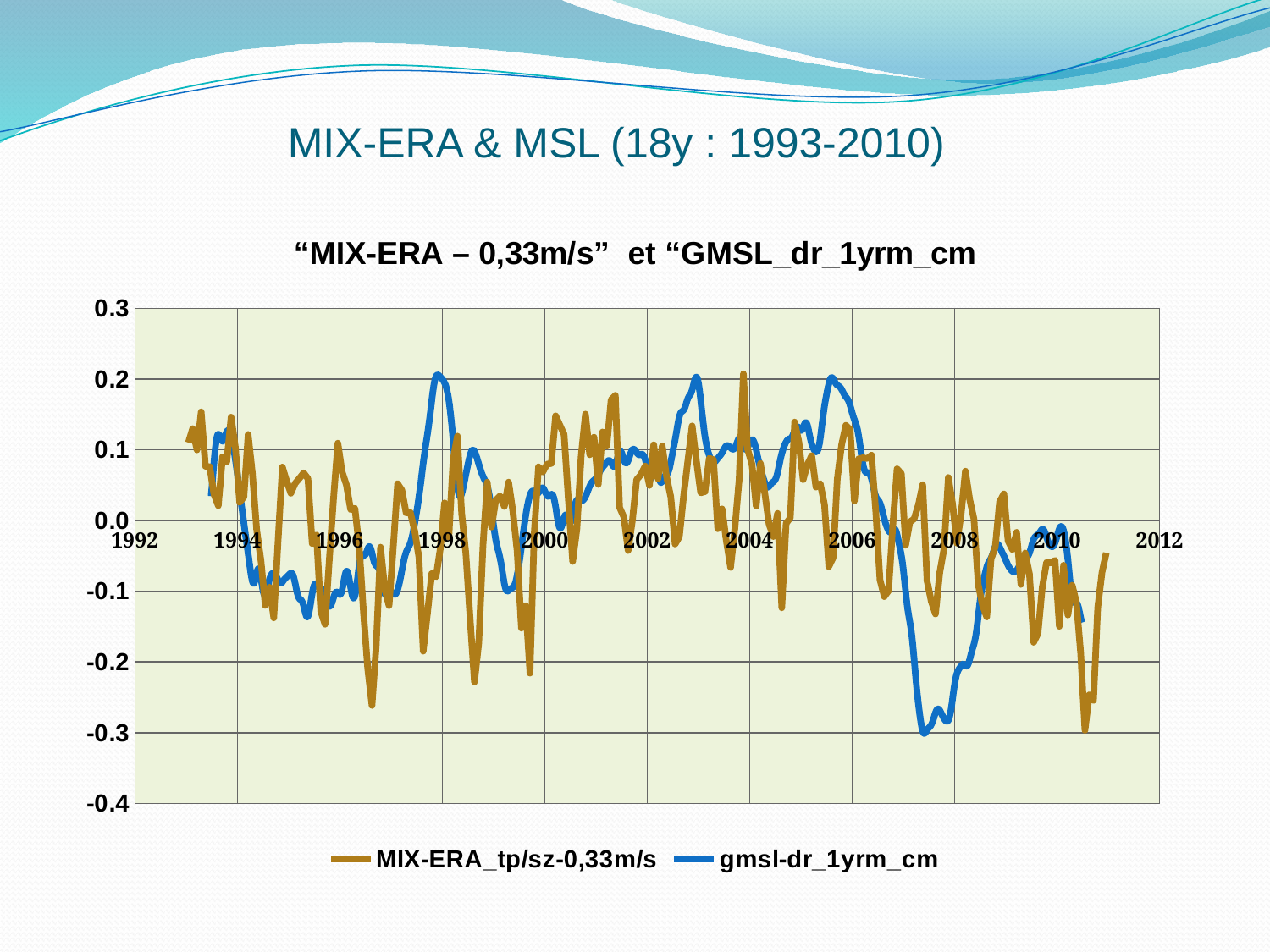
What colour is the gmsl-dr_1yrm_cm line? blue Is the lowest value of the MIX-ERA_tp/sz-0,33m/s series greater or less than -0.2? less Is the peak of the gmsl-dr_1yrm_cm series near 1998 greater or less than 0.1? greater Is the highest value of the MIX-ERA_tp/sz-0,33m/s series greater or less than 0.1? greater What kind of chart is shown on the slide? line chart Between 2006 and 2008, does the gmsl-dr_1yrm_cm line generally rise or fall? fall What are the two series names listed in the legend? MIX-ERA_tp/sz-0,33m/s and gmsl-dr_1yrm_cm At 1998, which series has the higher value? gmsl-dr_1yrm_cm How many series does the legend list? 2